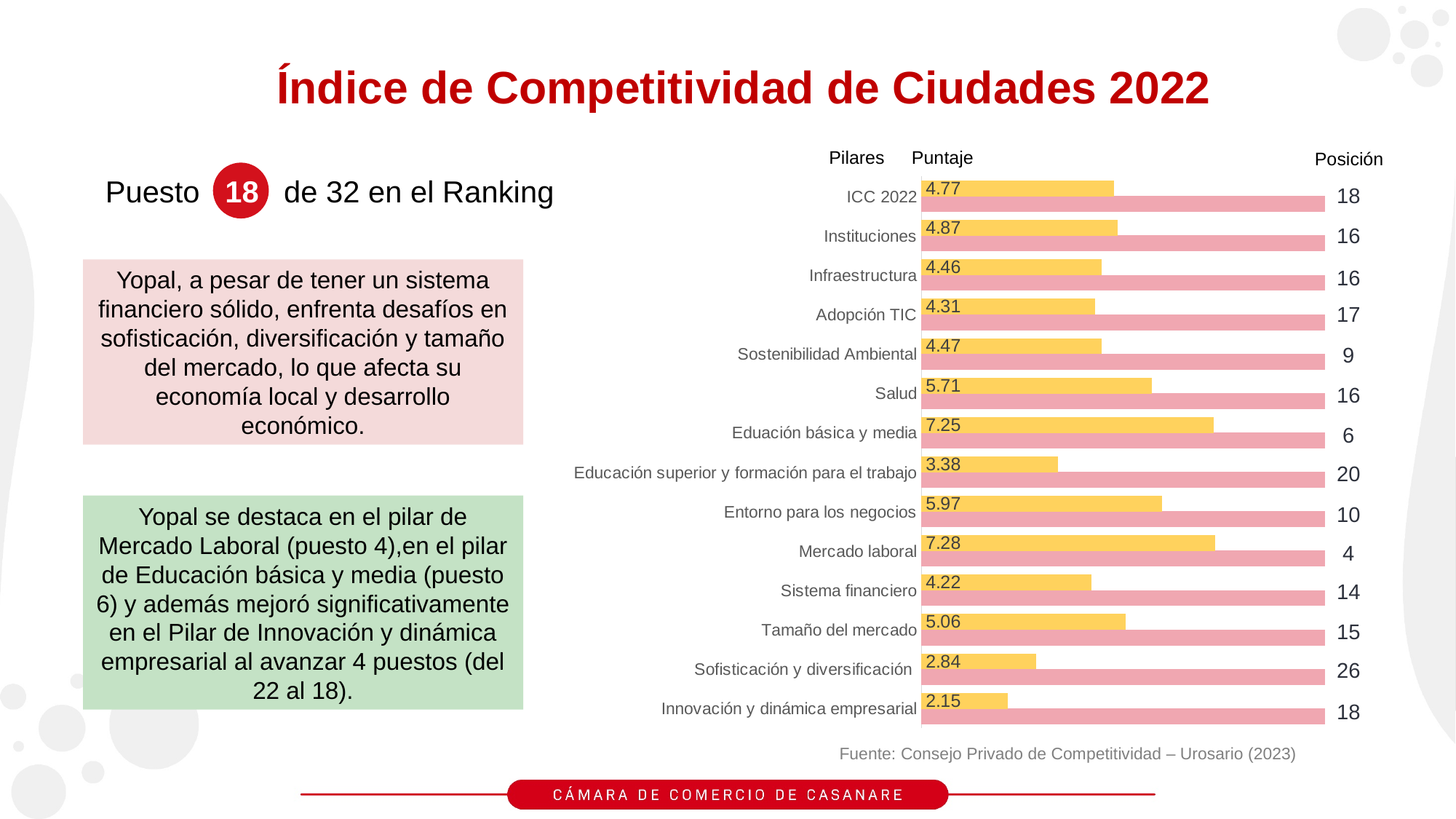
What colour are the Puntaje bars in the chart? Yellow What is the difference between the Puntaje for Eduación básica y media and the Puntaje for Educación superior y formación para el trabajo? 3.87 How many pillars (categories) are plotted in the chart? 14 What Posición is shown for Sostenibilidad Ambiental? 9 What kind of chart is shown on the slide? Bar chart Which has a higher Puntaje, Instituciones or Infraestructura? Instituciones Which pillar has the highest Puntaje? Mercado laboral What is the Puntaje value for Innovación y dinámica empresarial? 2.15 What is the Puntaje value for Salud? 5.71 What Posición is shown for Sofisticación y diversificación? 26 Which pillar has the lowest Puntaje? Innovación y dinámica empresarial What is the Puntaje value for Mercado laboral? 7.28